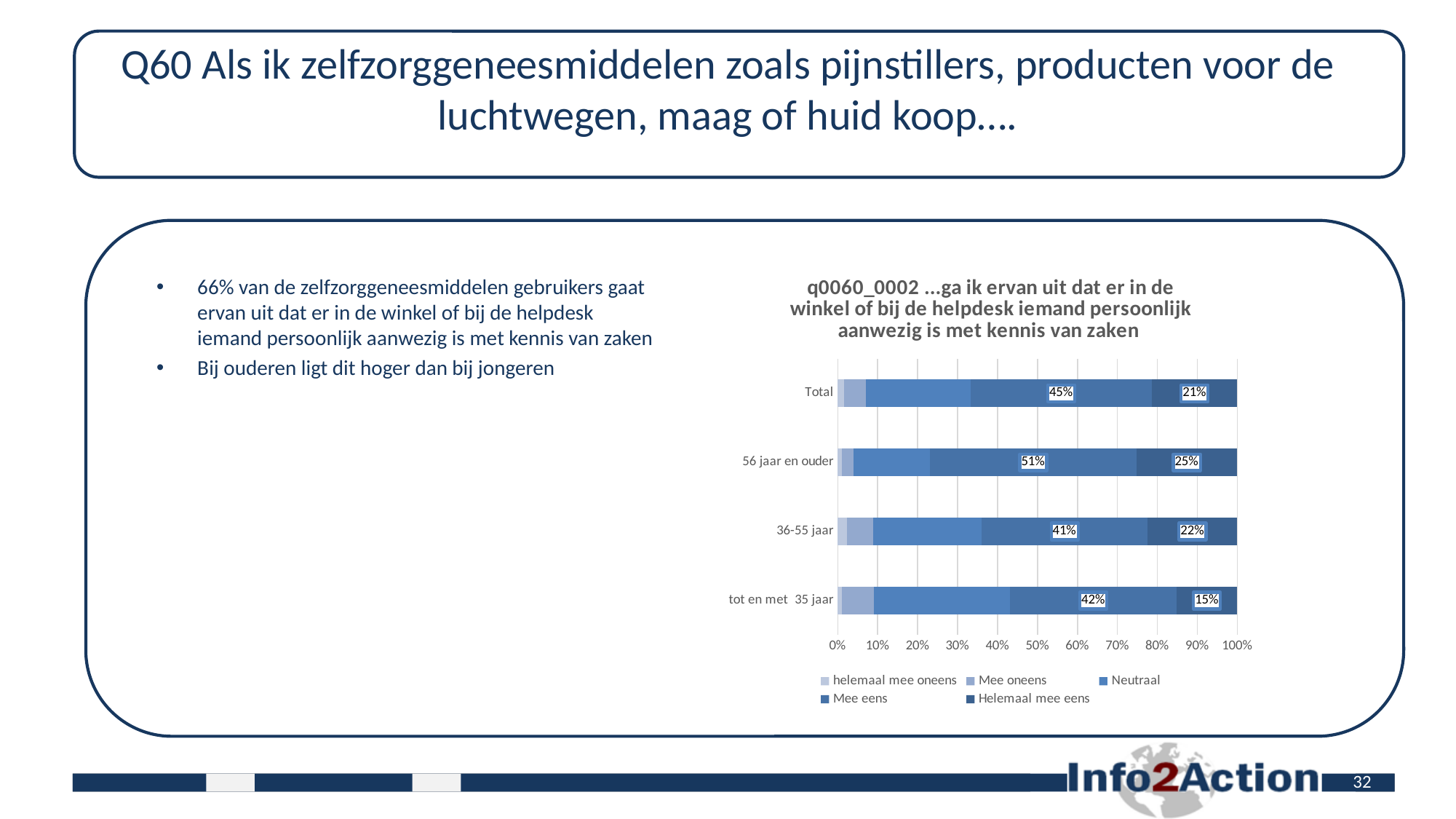
What is the value for 'Helemaal mee eens' for 'tot en met 35 jaar'? 15% What is the value for 'Helemaal mee eens' for '56 jaar en ouder'? 25% How many categories are shown on the chart? 4 What is the difference in 'Mee eens' between '56 jaar en ouder' and 'Total'? 6 percentage points How many series does the legend list? 5 Which category has the highest value for 'Mee eens'? 56 jaar en ouder Which category has the lowest value for 'Helemaal mee eens'? tot en met 35 jaar Which is larger: 'Helemaal mee eens' for '36-55 jaar' or for 'tot en met 35 jaar'? 36-55 jaar What is the value for 'Mee eens' in the 'Total' bar? 45% What is the value for 'Mee eens' for '36-55 jaar'? 41% Is the value for 'helemaal mee oneens' in the 'Total' bar greater or less than 10%? less What kind of chart is shown on the slide? Stacked bar chart